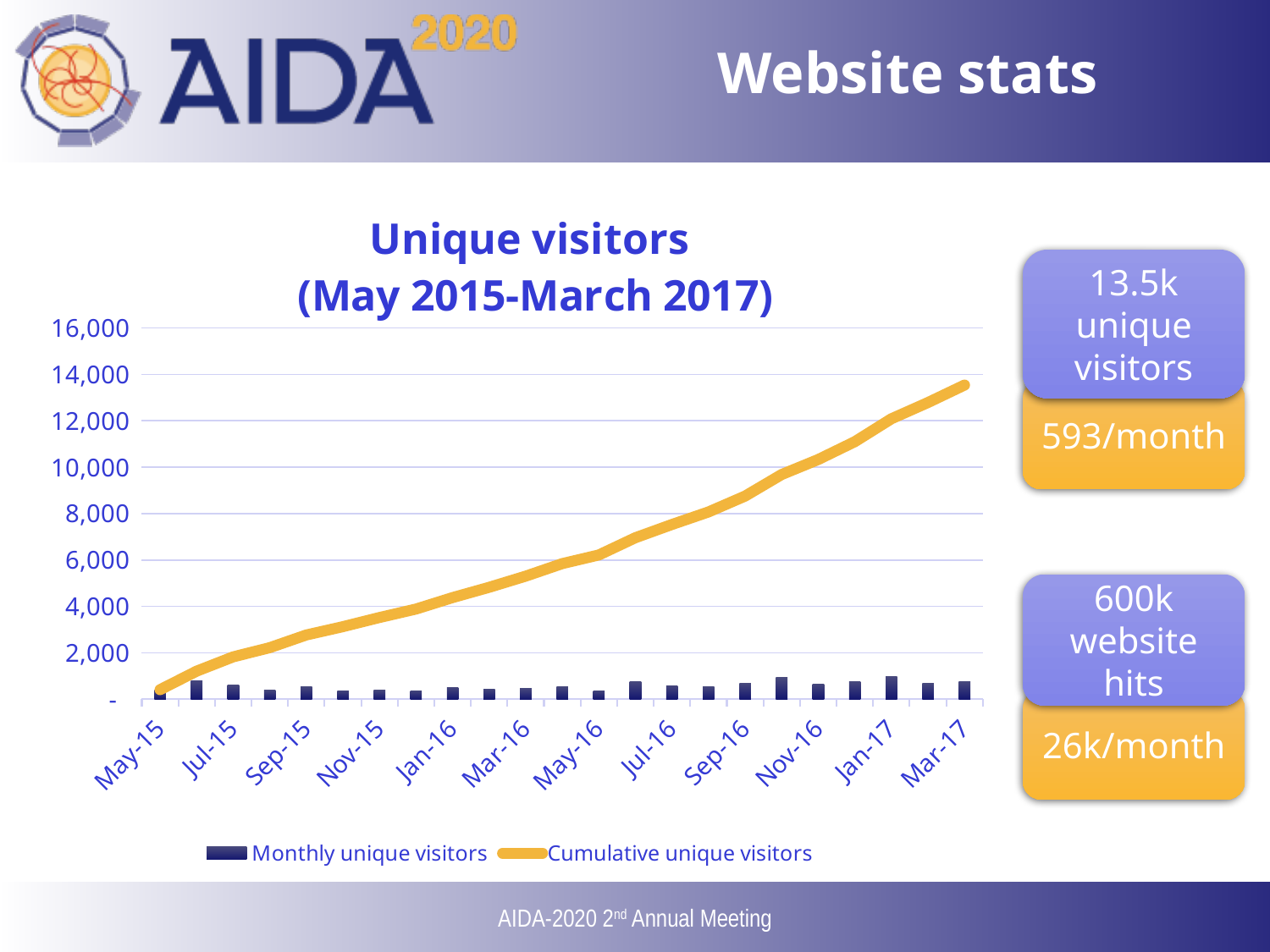
At which month does the Cumulative unique visitors line reach its highest value? Mar-17 Is the Cumulative unique visitors value for Sep-16 greater or less than 6,000? greater What kind of chart is shown on the slide? A combined bar and line chart Is the Cumulative unique visitors value for Jan-16 greater or less than 6,000? less How many series does the chart legend list? 2 Does the Cumulative unique visitors line rise or fall from May-15 to Mar-17? Rises What are the two series named in the chart legend? Monthly unique visitors and Cumulative unique visitors What is the title of the chart? Unique visitors (May 2015-March 2017) At which month is the Cumulative unique visitors line at its lowest value? May-15 Is the Cumulative unique visitors value for Mar-17 greater or less than 12,000? greater How many month labels are shown on the x axis? 12